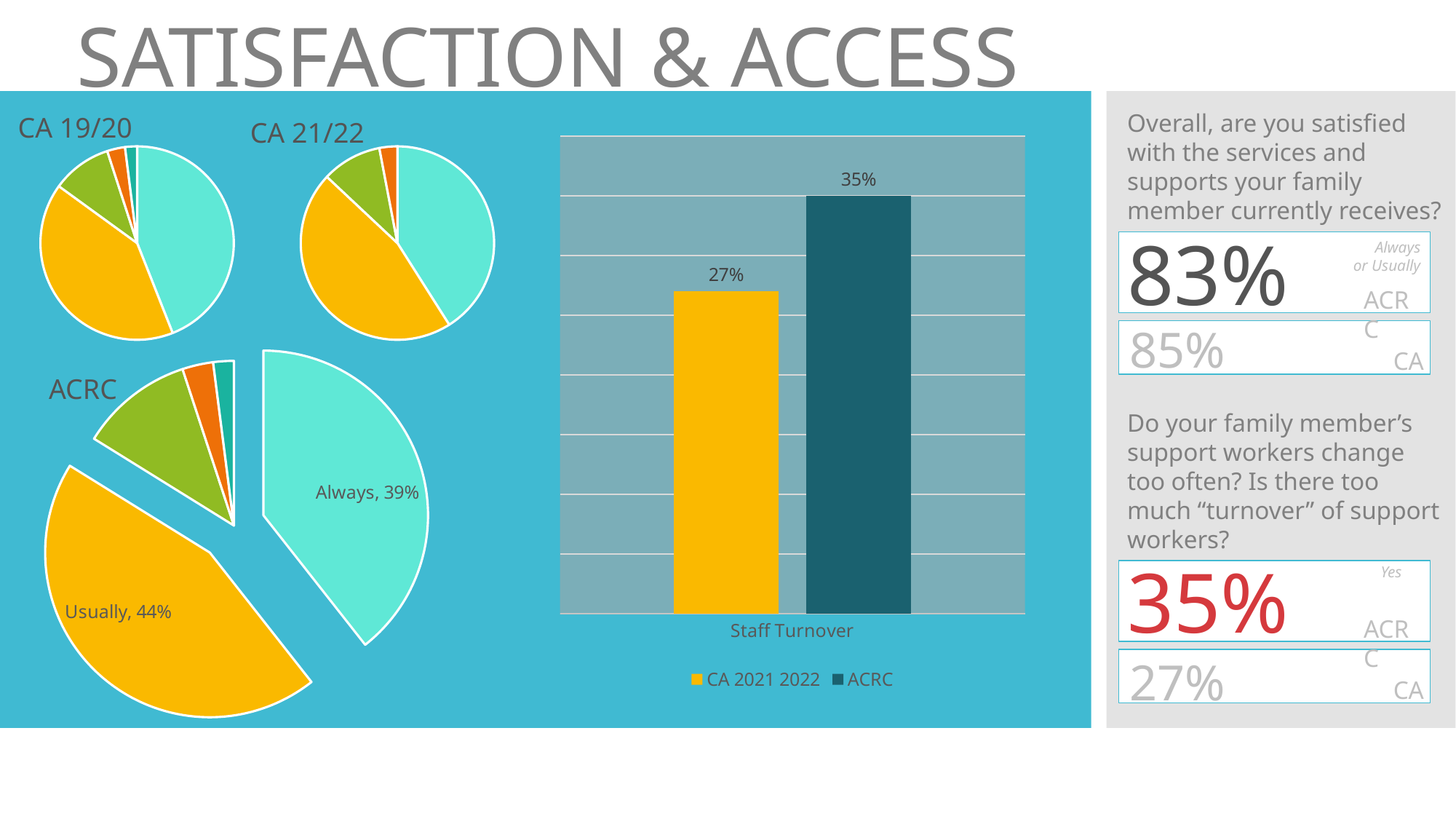
In the ACRC pie chart, which labelled slice is larger, Always or Usually? Usually In the Staff Turnover bar chart, what is the value for CA 2021 2022? 27% How many pie charts are shown on the slide? 3 In the Staff Turnover bar chart, is the value for CA 2021 2022 larger or smaller than the value for ACRC? smaller What kind of chart is the Staff Turnover chart? bar chart In the ACRC pie chart, what share is labelled for the Always slice? 39% How many series does the legend of the Staff Turnover bar chart list? 2 What is the category label on the x axis of the bar chart? Staff Turnover In the Staff Turnover bar chart, which series has the higher value? ACRC In the Staff Turnover bar chart, what is the difference between the ACRC value and the CA 2021 2022 value? 8% In the ACRC pie chart, what share is labelled for the Usually slice? 44% In the Staff Turnover bar chart, what is the value for ACRC? 35%